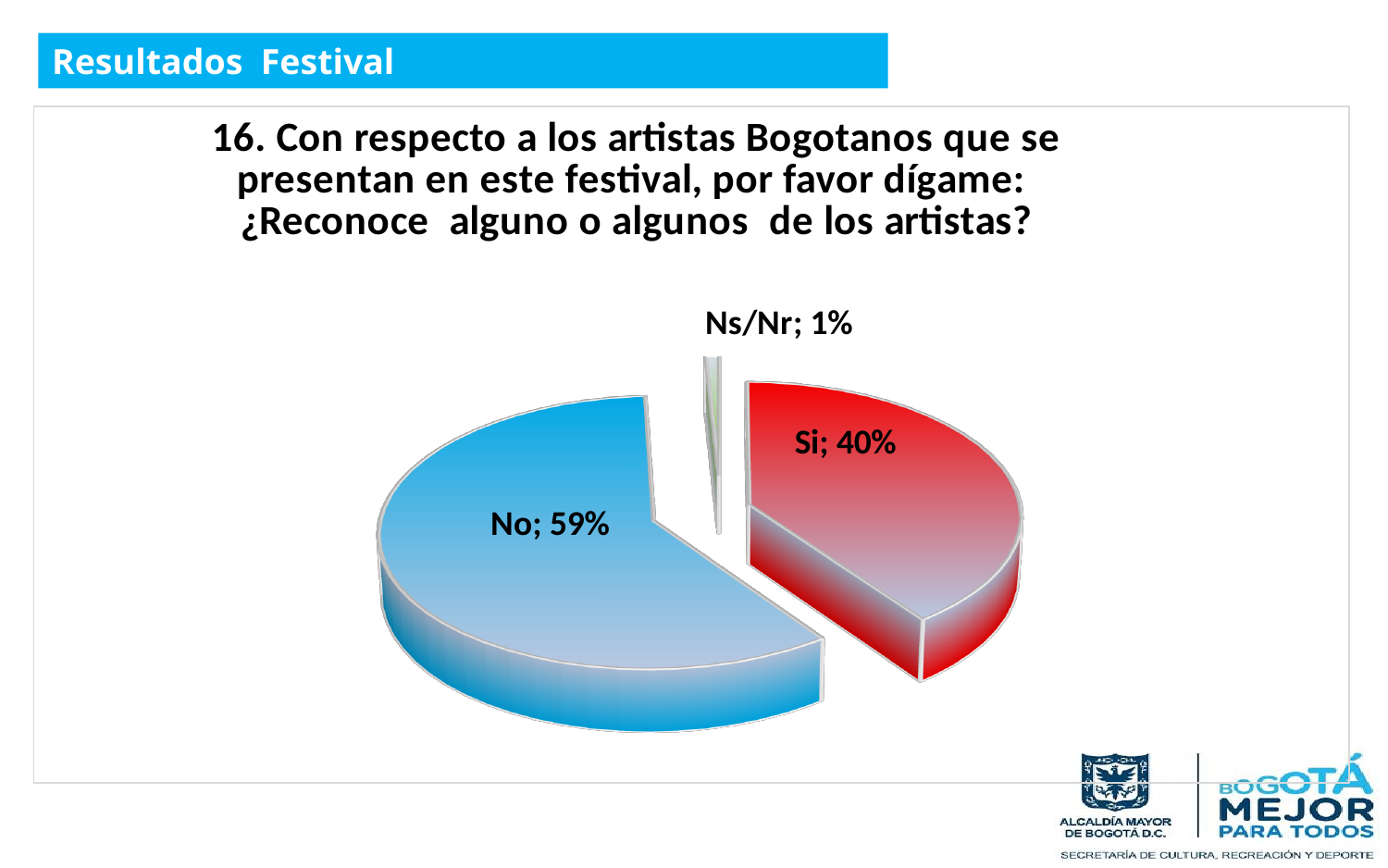
What share of the pie does the "Si" slice represent? 40% What percentage of respondents answered "Si"? 40% What percentage of respondents answered "No"? 59% What kind of chart is shown on the slide? Pie chart What is the difference in percentage points between "No" and "Si"? 19 What colour is the "Si" slice? Red Which response has the largest share of the pie? No How many slices does the pie chart have? 3 What percentage is shown for "Ns/Nr"? 1% Which is larger, the share for "Si" or the share for "Ns/Nr"? Si What colour is the "No" slice? Blue Which response has the smallest share of the pie? Ns/Nr